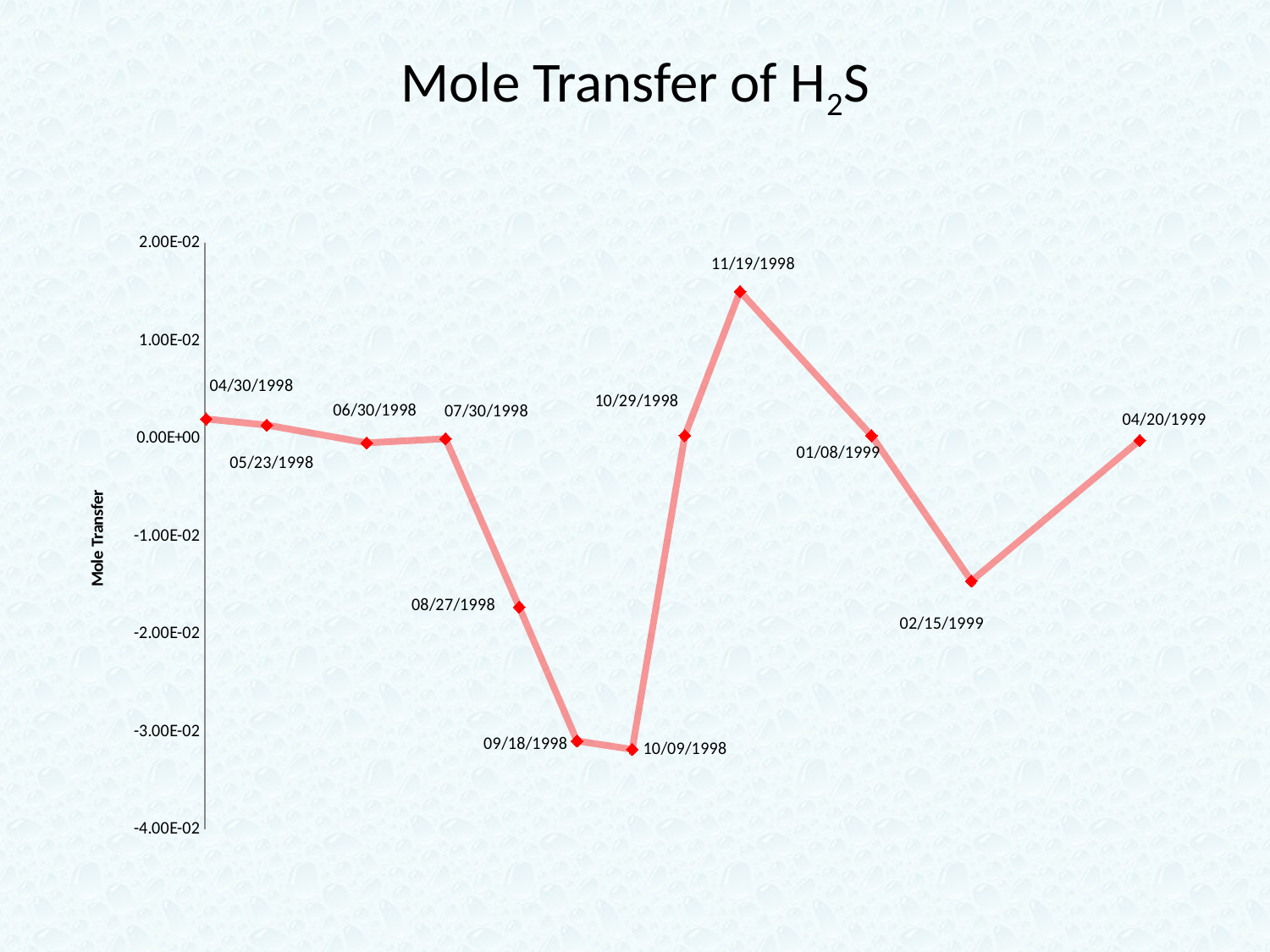
What kind of chart is shown on the slide? line chart What is the title of the chart? Mole Transfer of H2S Which has the larger value, 11/19/1998 or 04/30/1998? 11/19/1998 Do the values rise or fall from 07/30/1998 to 10/09/1998? fall How many data points are plotted on the line? 12 Is the value for 02/15/1999 greater or less than -1.00E-02? less Is the value for 11/19/1998 greater or less than 1.00E-02? greater What is the label on the vertical axis? Mole Transfer Is the value for 08/27/1998 greater or less than -1.00E-02? less Which has the larger value, 08/27/1998 or 09/18/1998? 08/27/1998 Which date has the highest mole transfer value? 11/19/1998